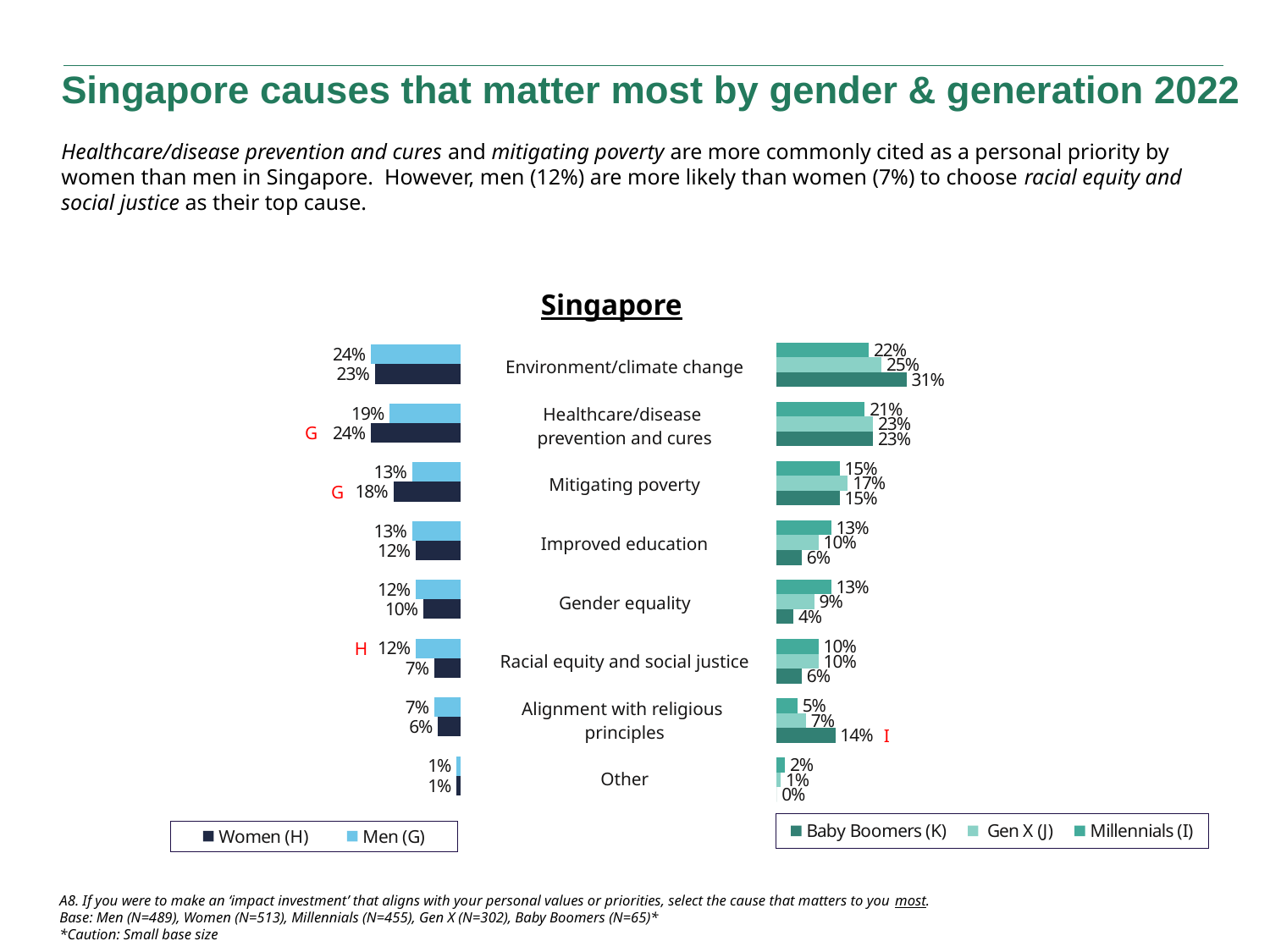
On the left chart (Women/Men), how many series does the legend list? 2 How many causes (categories) are shown on the right chart (generations)? 8 On the left chart (Women/Men), which cause has the lowest value for men? Other On the left chart (Women/Men), what is the difference between women and men for Mitigating poverty? 5 percentage points On the left chart (Women/Men), what percentage of men chose Environment/climate change? 24% On the right chart (generations), what is the difference between Baby Boomers and Millennials for Alignment with religious principles? 9 percentage points On the right chart (generations), what percentage of Baby Boomers chose Environment/climate change? 31% On the left chart (Women/Men), which cause has the highest value for women? Healthcare/disease prevention and cures On the left chart (Women/Men), is the value for Racial equity and social justice larger for women or for men? Men On the right chart (generations), what percentage of Millennials chose Gender equality? 13% On the left chart (Women/Men), what percentage of women chose Healthcare/disease prevention and cures? 24% What type of chart is used on the slide? Bar chart